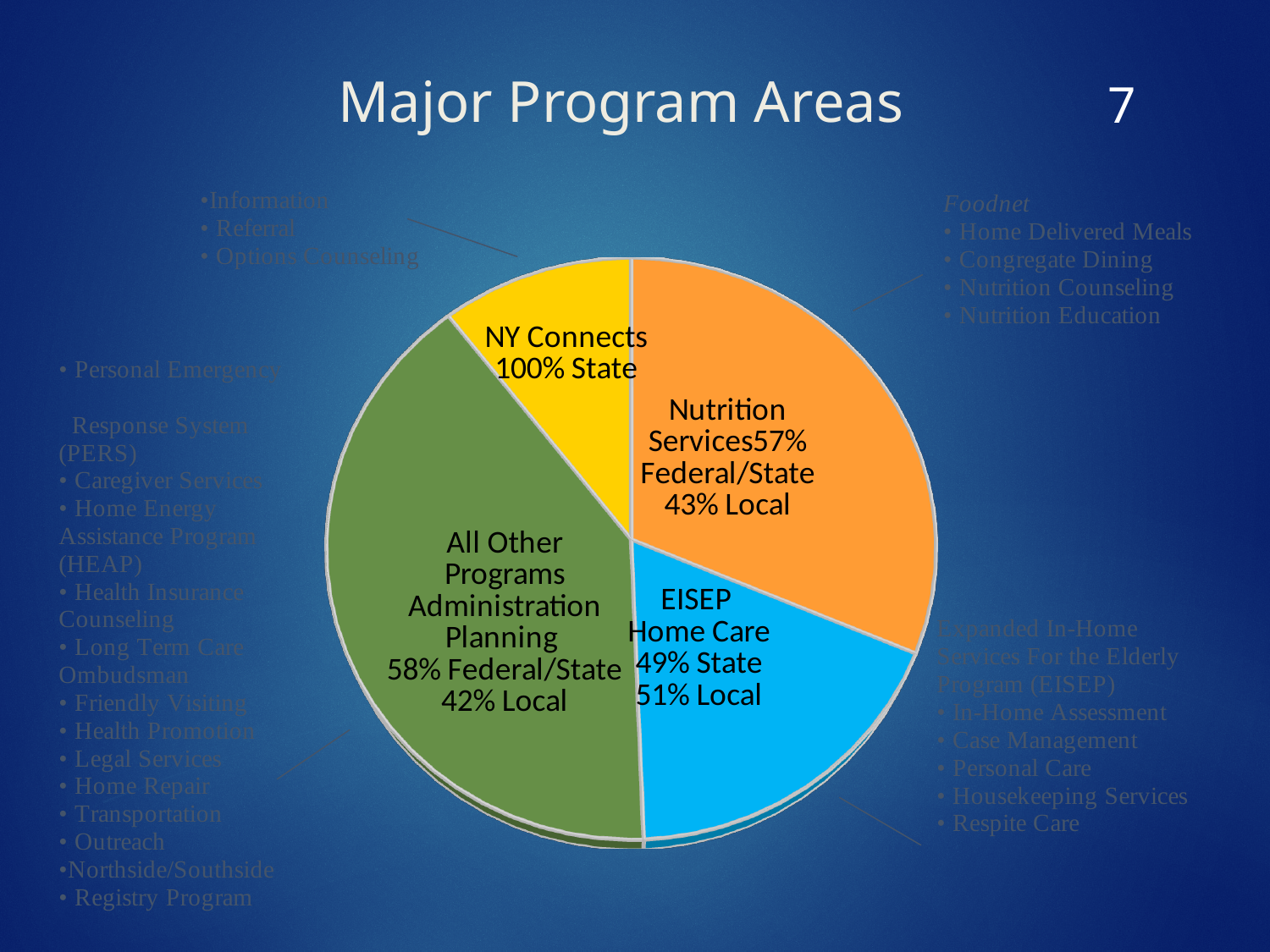
Which slice is larger, NY Connects or EISEP Home Care? EISEP Home Care Which slice of the pie chart is the largest? All Other Programs Administration Planning Which slice is larger, Nutrition Services or EISEP Home Care? Nutrition Services According to the label on the All Other Programs Administration Planning slice, what share of its funding is Federal/State? 58% Federal/State According to the label on the NY Connects slice, what share of its funding is State? 100% State Which slice of the pie chart is the smallest? NY Connects According to the label on the EISEP Home Care slice, what share of its funding is State? 49% State What kind of chart is shown on the slide? pie chart What colour is the EISEP Home Care slice of the pie chart? blue According to the label on the Nutrition Services slice, what share of its funding is Local? 43% Local What is the title of the slide containing the pie chart? Major Program Areas How many slices does the pie chart have? 4